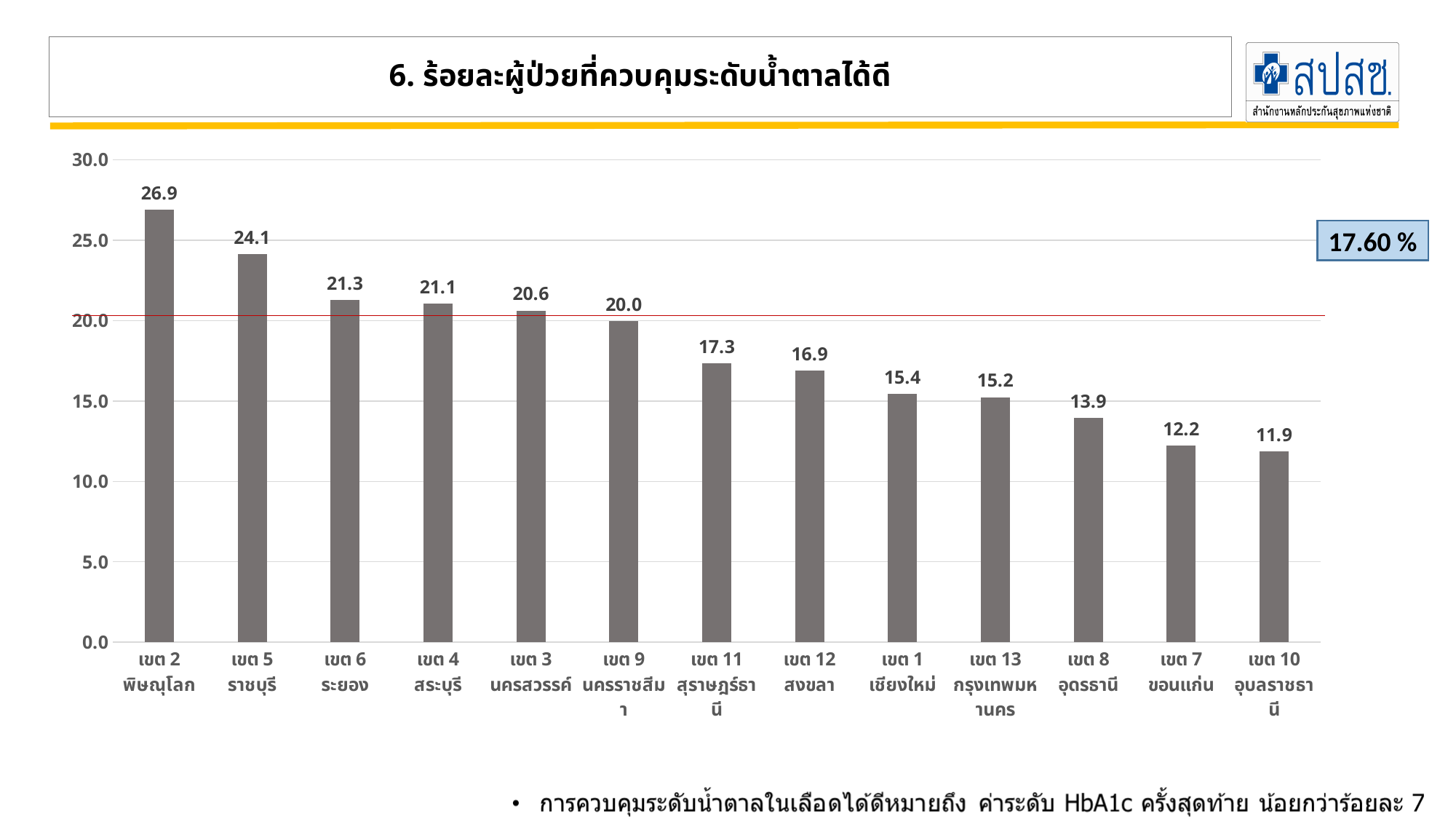
What kind of chart is shown on the slide? bar chart Do the values rise or fall from left to right along the x axis? fall What overall percentage is shown in the box at the top right of the chart? 17.60 % What is the difference between the values for เขต 5 ราชบุรี and เขต 7 ขอนแก่น? 11.9 What is the value for เขต 2 พิษณุโลก? 26.9 Is the value for เขต 8 อุดรธานี greater or less than 15.0? less What is the value for เขต 12 สงขลา? 16.9 Which region has the highest value? เขต 2 พิษณุโลก Which region has the lowest value? เขต 10 อุบลราชธานี What is the value for เขต 13 กรุงเทพมหานคร? 15.2 Which is larger, the value for เขต 6 ระยอง or the value for เขต 11 สุราษฎร์ธานี? เขต 6 ระยอง How many regions are shown on the chart? 13